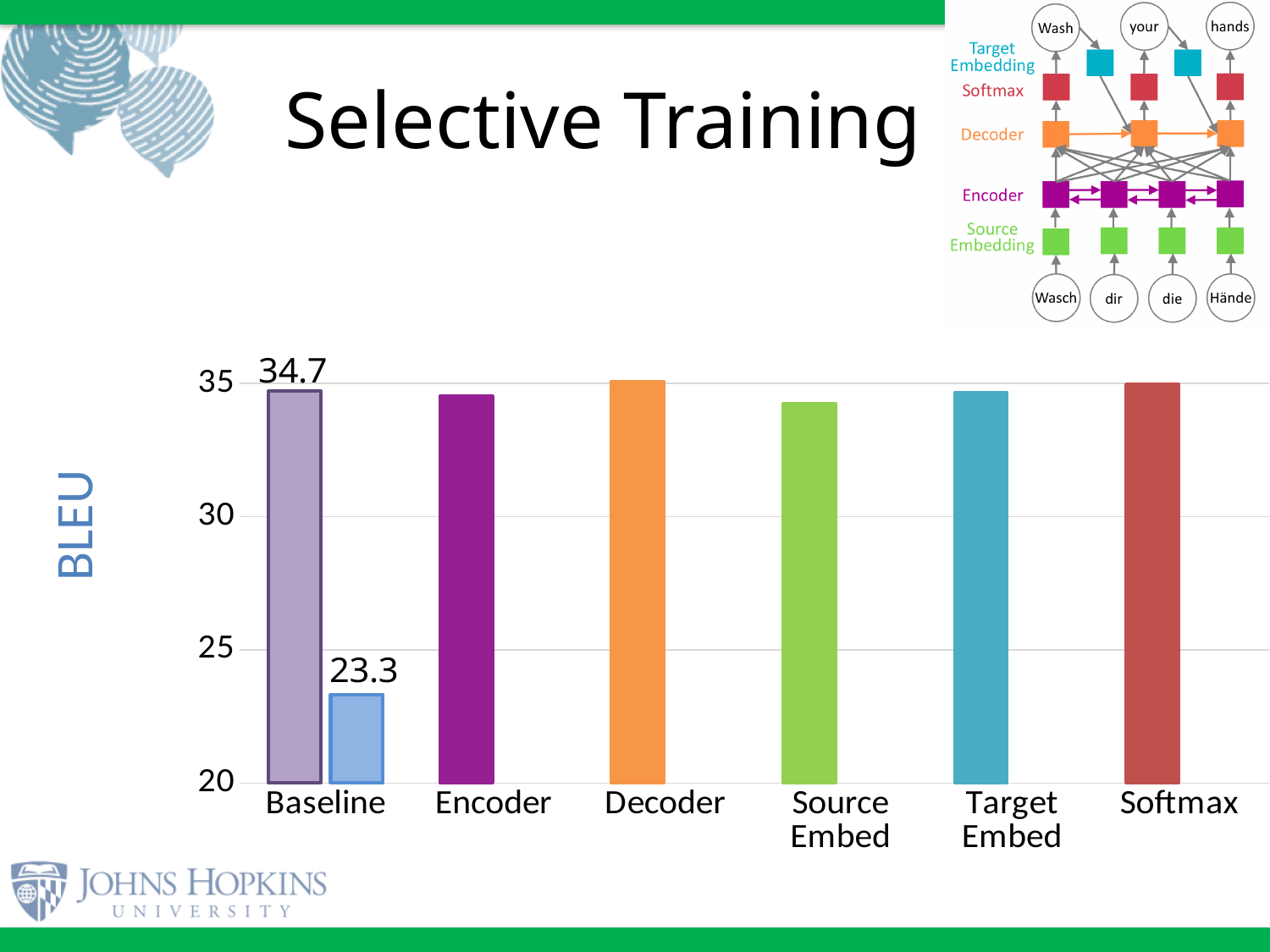
Which is larger, the Source Embed bar or the 23.3 Baseline bar? Source Embed Is the value for Encoder greater or less than 30? greater Is the value for Source Embed greater or less than 35? less What colour is the Decoder bar? orange Which is larger, the Decoder bar or the Source Embed bar? Decoder What is the value of the shorter Baseline bar? 23.3 Which category has the lowest bar on the chart? Baseline What is the label of the y axis? BLEU What is the difference between the two Baseline bars, 34.7 and 23.3? 11.4 How many categories are shown on the x axis? 6 What is the value of the taller Baseline bar? 34.7 What kind of chart is shown on the slide? bar chart